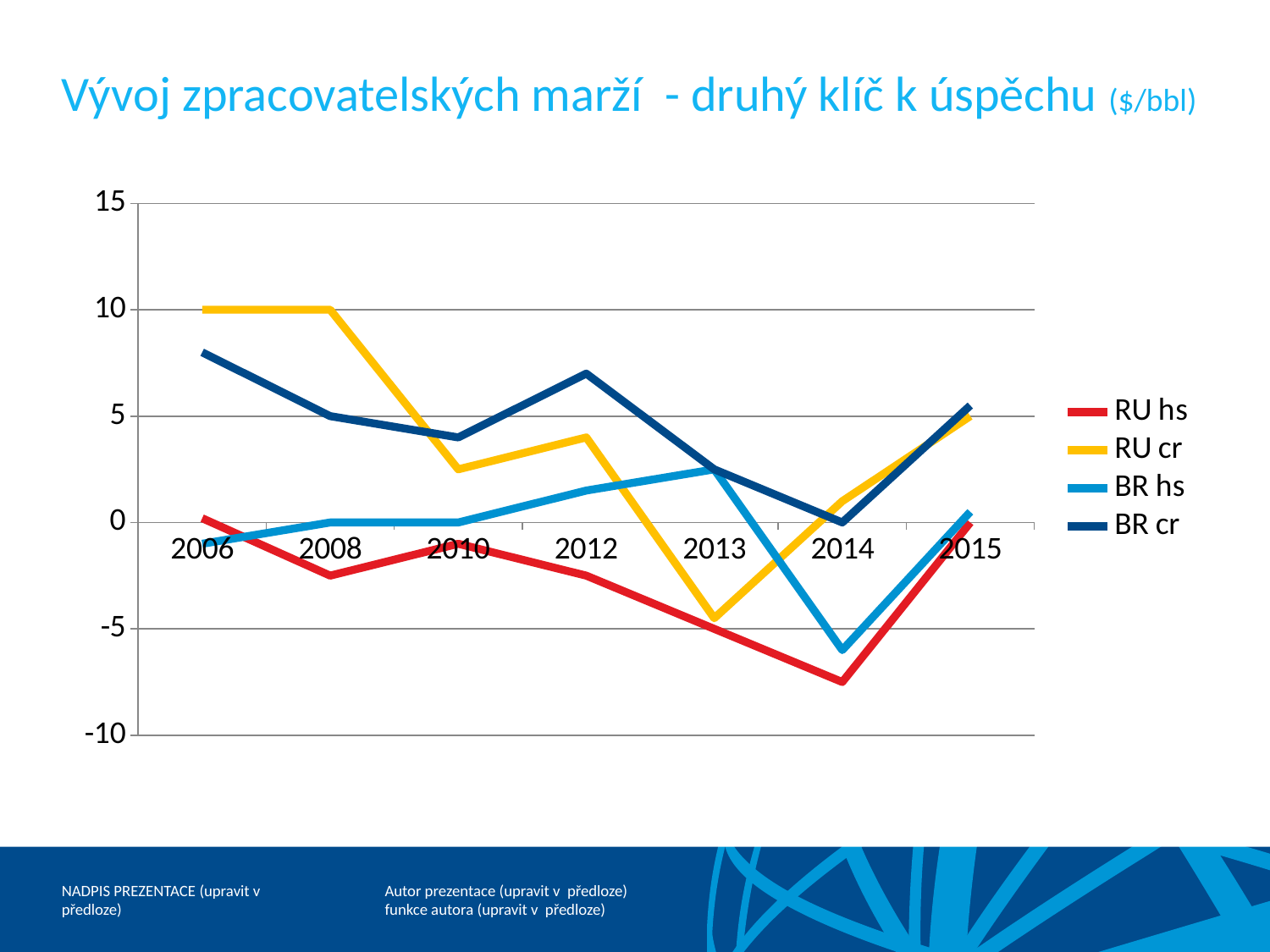
Is the value for RU cr in 2013 greater or less than 0? less In 2012, which is larger: BR cr or RU cr? BR cr How many years are shown on the x axis? 7 Does the RU hs line rise or fall from 2006 to 2014? fall What kind of chart is shown on the slide? line chart Is the value for RU hs in 2014 greater or less than -5? less What is the value of RU cr in 2006? 10 Which series has the highest value in 2006? RU cr How many series does the legend list? 4 Is the value for BR cr in 2012 greater or less than 5? greater What is the value of BR cr in 2014? 0 What is the value of RU cr in 2008? 10